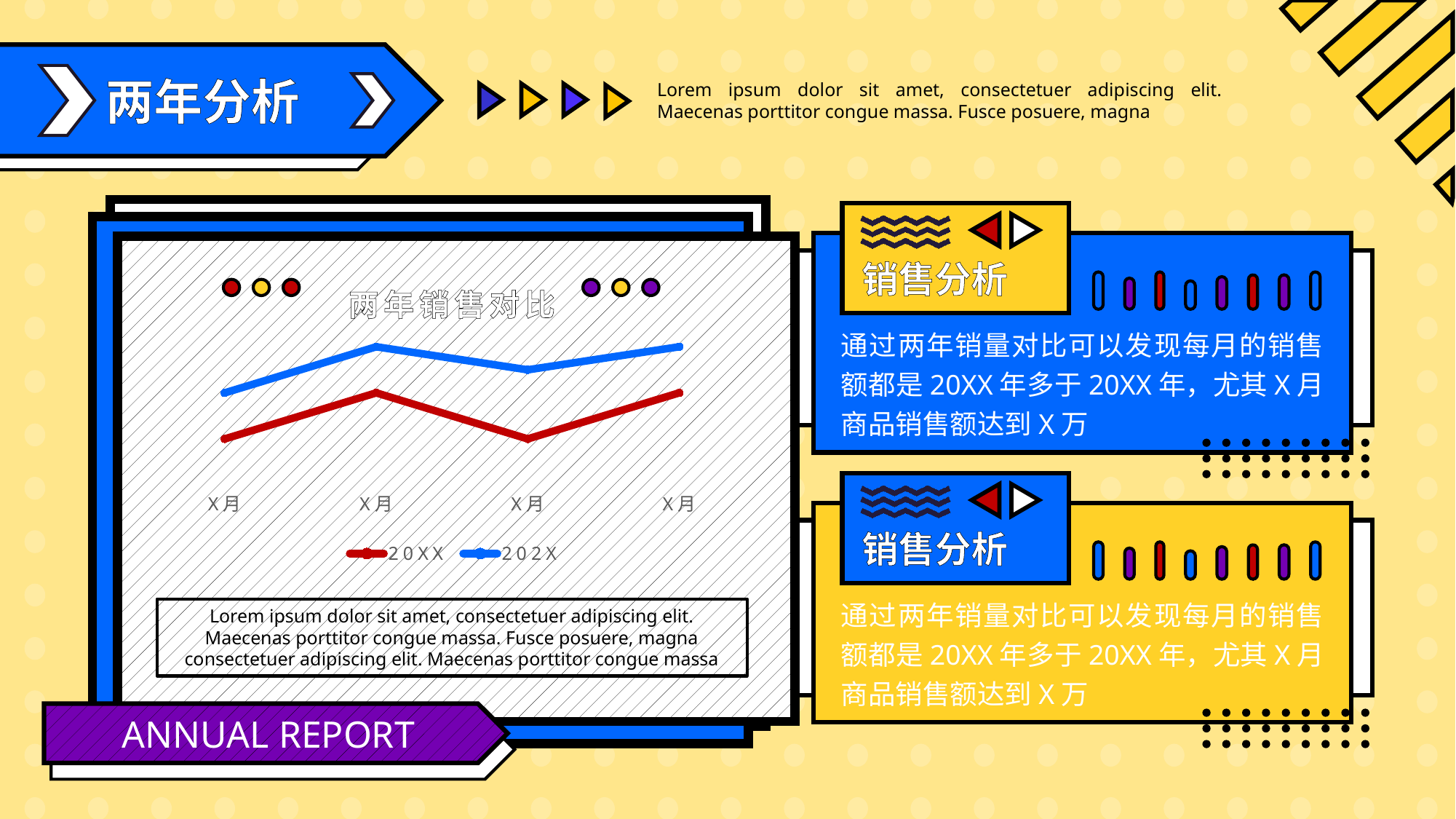
Which series has the higher values at every point on the chart, 20XX or 202X? 202X Does the 20XX line rise or fall between the third and fourth points? rise Which series is lower at the third point, 20XX or 202X? 20XX Does the 202X line rise or fall between the second and third points? fall What are the two series names shown in the chart legend? 20XX and 202X How many series does the chart's legend list? 2 What is the title of the chart? 两年销售对比 How many points are plotted along the x axis for each series? 4 What kind of chart is shown on the slide? line chart Which series is plotted in red? 20XX Does the 20XX line rise or fall between the first and second points? rise